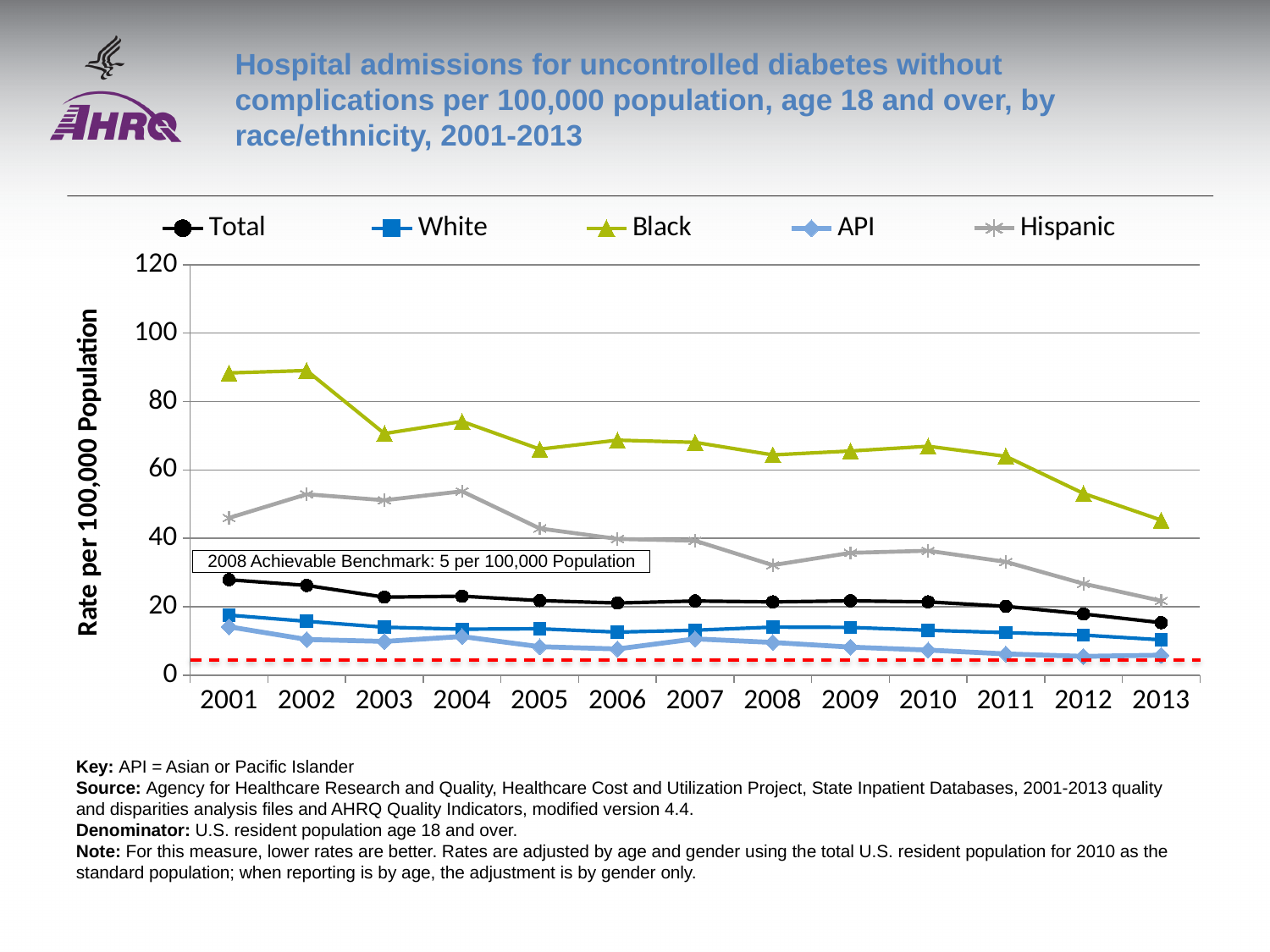
How many years are plotted along the x axis? 13 Does the Black series rise or fall from 2001 to 2013? fall Is the value for Hispanic in 2013 greater or less than 40? less Is the value for Black in 2001 greater or less than 80? greater Is the value for Total in 2001 greater or less than 20? greater How many series does the legend list? 5 Which race/ethnicity series has the highest rate in 2001? Black What is the 2008 Achievable Benchmark shown on the chart? 5 per 100,000 Population What kind of chart is shown on the slide? line chart Which is larger for the Black series: the 2002 value or the 2003 value? 2002 In 2004, which is larger: the Hispanic value or the Total value? Hispanic Which series has the lowest rate in 2013? API